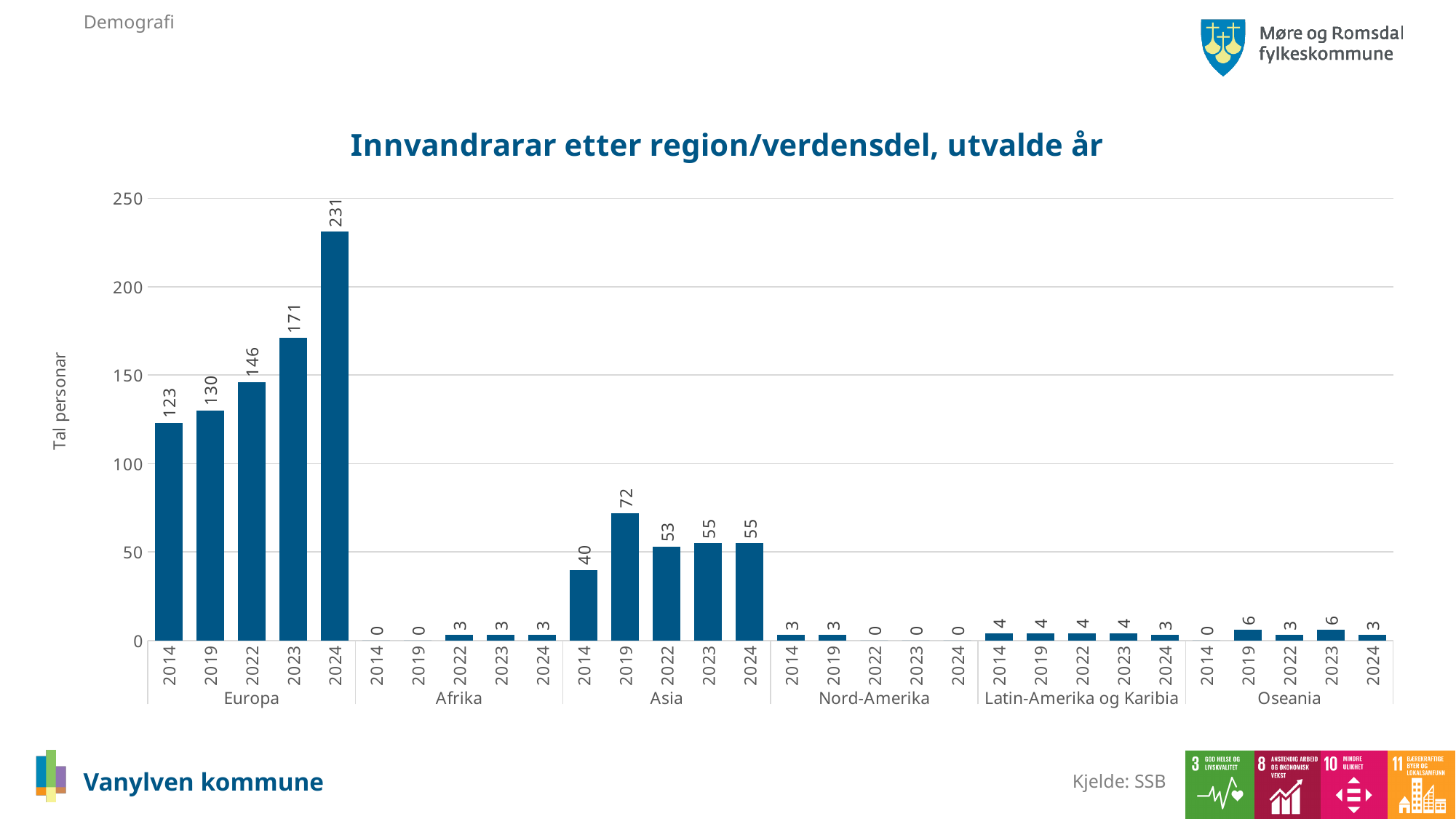
How many regions are shown on the x axis? 6 What kind of chart is this? Bar chart Which region has the highest value in 2024? Europa Which is larger: Asia in 2014 or Asia in 2022? Asia in 2022 What is the value for Europa in 2024? 231 What is the value for Oseania in 2023? 6 What is the difference between the Europa values for 2024 and 2023? 60 What is the value for Asia in 2019? 72 Is the value for Europa in 2023 greater or less than 150? greater What is the value for Nord-Amerika in 2022? 0 Do the values for Europa rise or fall from 2014 to 2024? Rise Which year has the lowest value for Europa? 2014